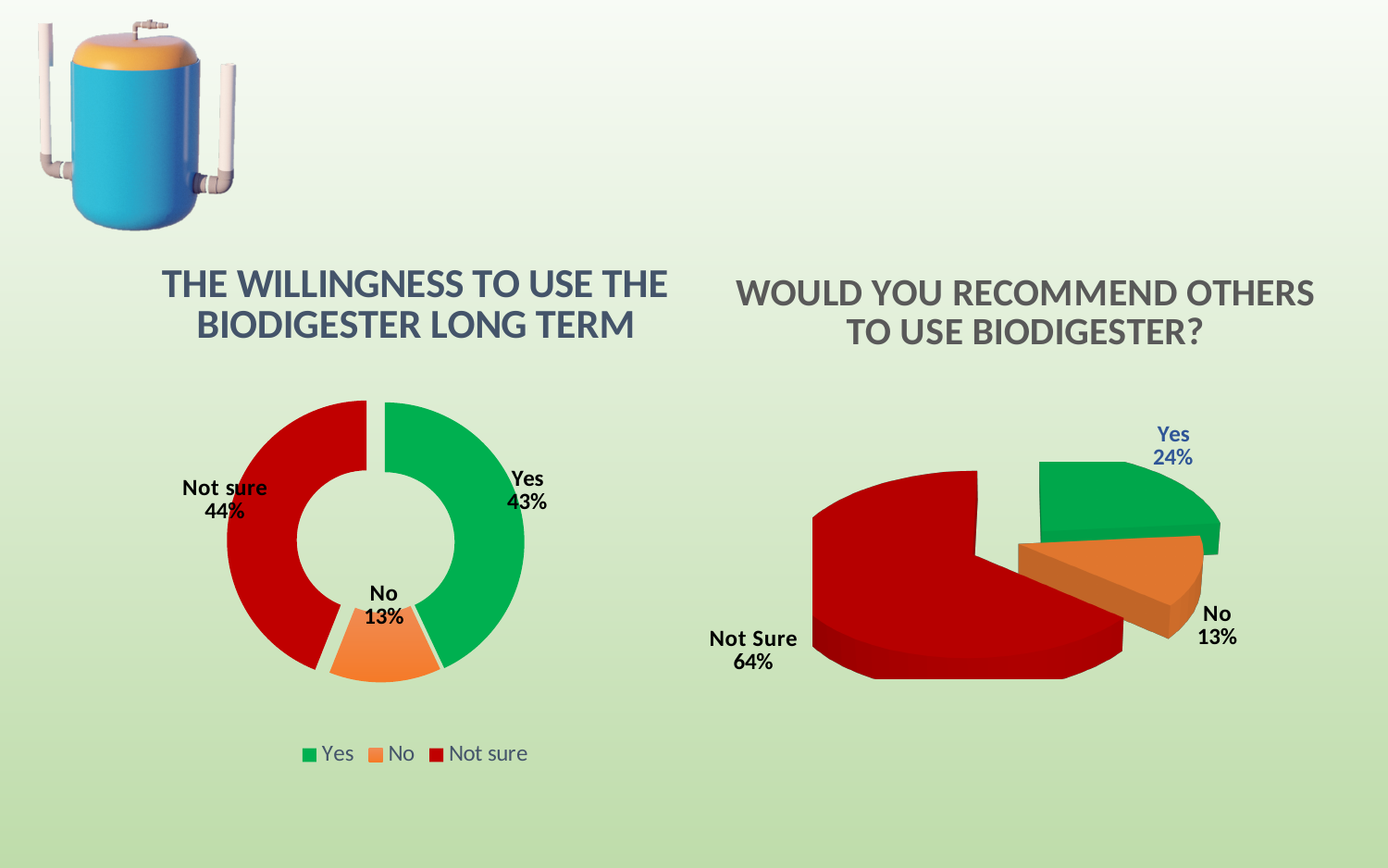
In the chart titled 'Would you recommend others to use biodigester?', what percentage answered Not Sure? 64% What kind of chart is the chart titled 'Would you recommend others to use biodigester?'? Pie chart In the chart titled 'The willingness to use the biodigester long term', what percentage answered Yes? 43% How many entries does the legend of the chart titled 'The willingness to use the biodigester long term' list? 3 In the chart titled 'The willingness to use the biodigester long term', which response has the smallest share? No In the chart titled 'Would you recommend others to use biodigester?', which is larger, the Yes share or the No share? Yes In the chart titled 'Would you recommend others to use biodigester?', what percentage answered Yes? 24% How many categories does the chart titled 'The willingness to use the biodigester long term' show? 3 In the chart titled 'Would you recommend others to use biodigester?', what is the difference between the Not Sure and Yes shares? 40% In the chart titled 'Would you recommend others to use biodigester?', which response has the largest share? Not Sure In the chart titled 'The willingness to use the biodigester long term', what is the difference between the Yes and No shares? 30% In the chart titled 'The willingness to use the biodigester long term', what percentage answered Not sure? 44%